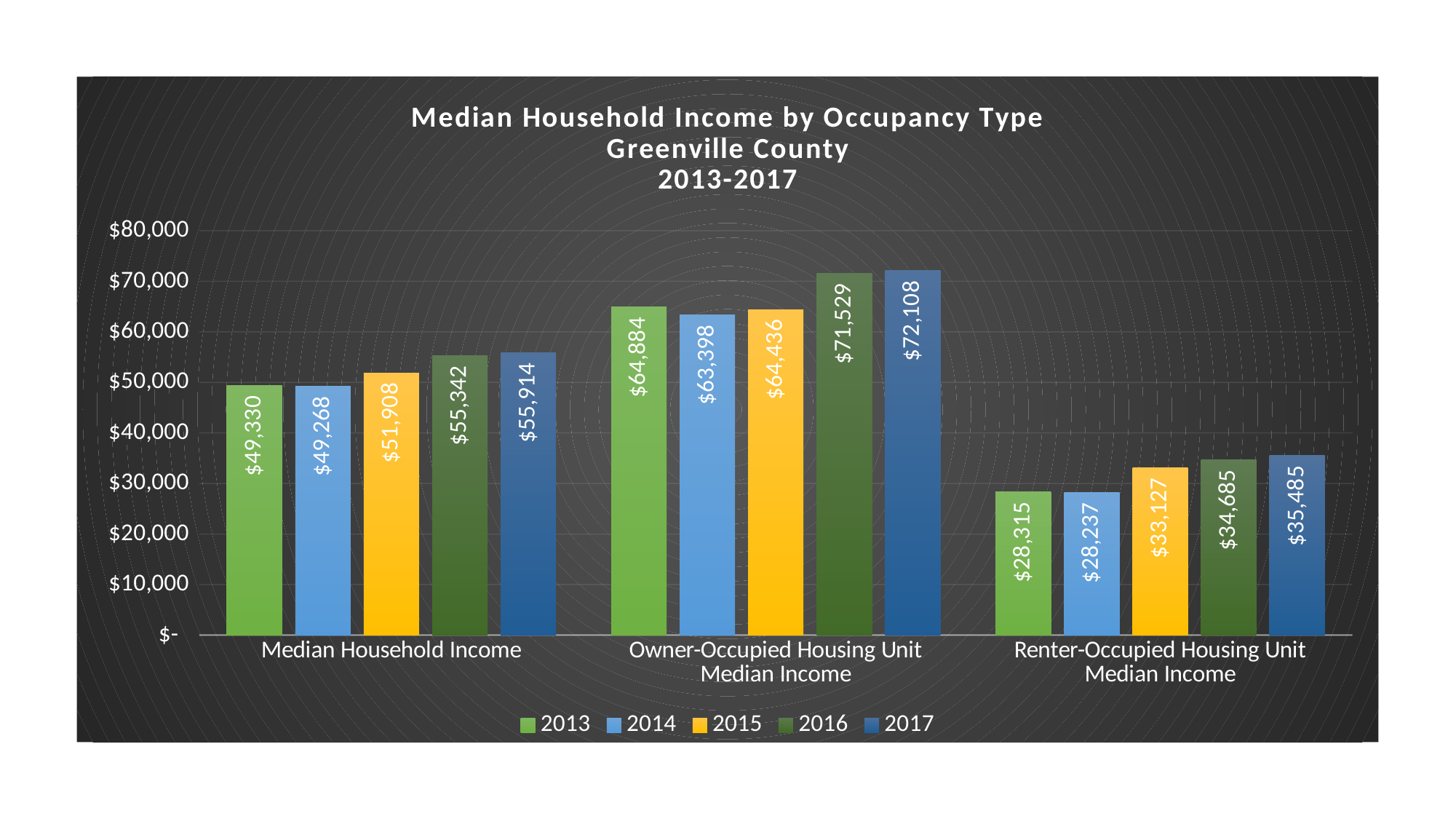
How many categories are shown on the x axis? 3 What is the Renter-Occupied Housing Unit Median Income for 2013? $28,315 Which is larger: the Owner-Occupied Housing Unit Median Income in 2013 or in 2014? 2013 How many series does the legend list? 5 Which year has the highest Owner-Occupied Housing Unit Median Income? 2017 Does the Renter-Occupied Housing Unit Median Income rise or fall from 2014 to 2017? Rise What is the Owner-Occupied Housing Unit Median Income for 2017? $72,108 What is the difference between the Median Household Income in 2017 and in 2013? $6,584 Which year has the lowest Renter-Occupied Housing Unit Median Income? 2014 What kind of chart is shown on the slide? Bar chart What is the Median Household Income for 2015? $51,908 What is the title of the chart? Median Household Income by Occupancy Type Greenville County 2013-2017